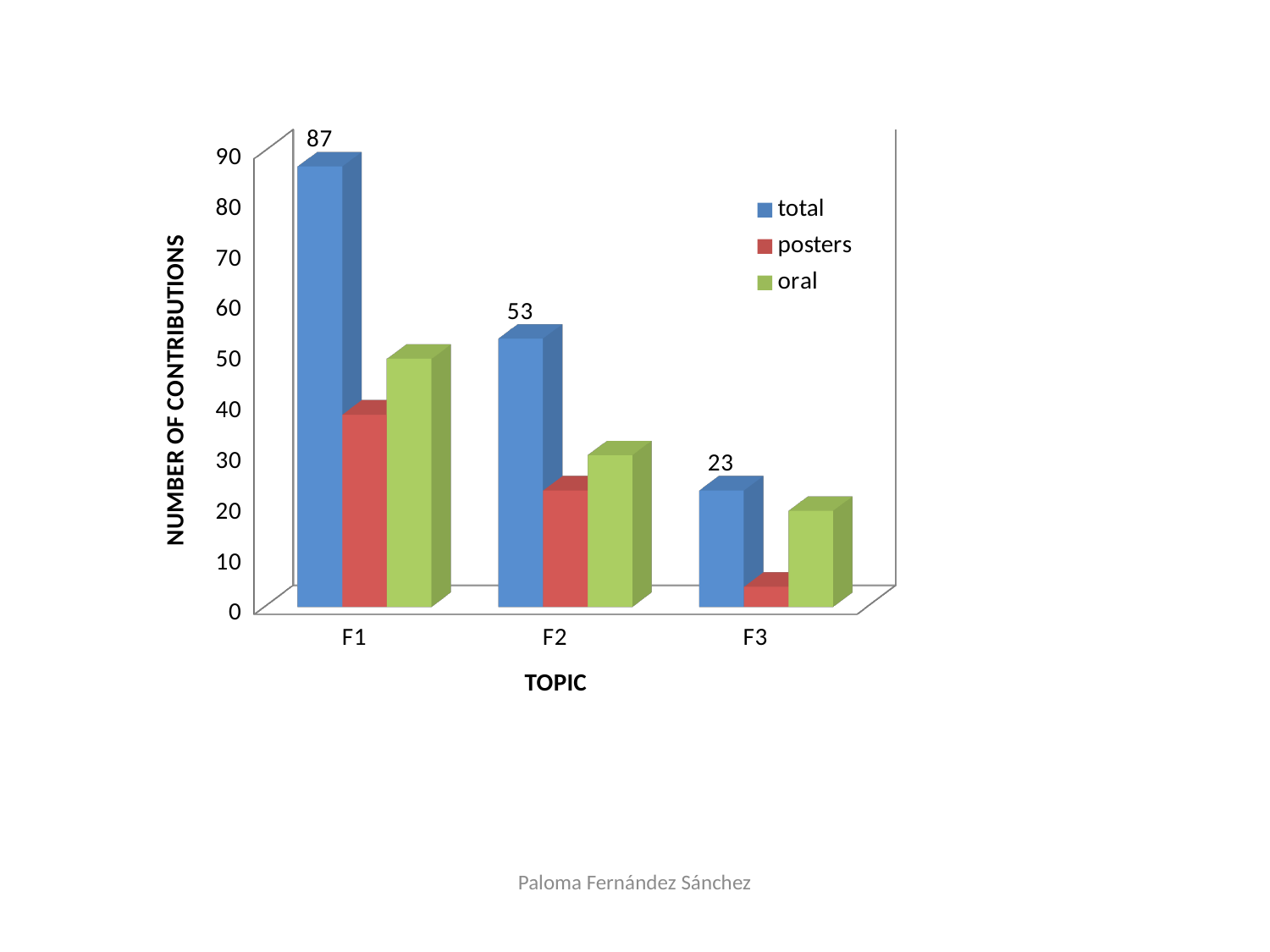
Which topic has the highest total number of contributions? F1 Is the value for oral in F3 greater or less than 10? greater What kind of chart is shown on the slide? Bar chart How many series does the legend list? 3 Which topic has the lowest total number of contributions? F3 Is the value for posters in F2 greater or less than 30? less What is the difference between the total for F1 and the total for F2? 34 What is the difference between the total for F2 and the total for F3? 30 What is the value of the total series for F3? 23 Is the value for posters in F3 greater or less than 10? less What is the value of the total series for F1? 87 What is the value of the total series for F2? 53